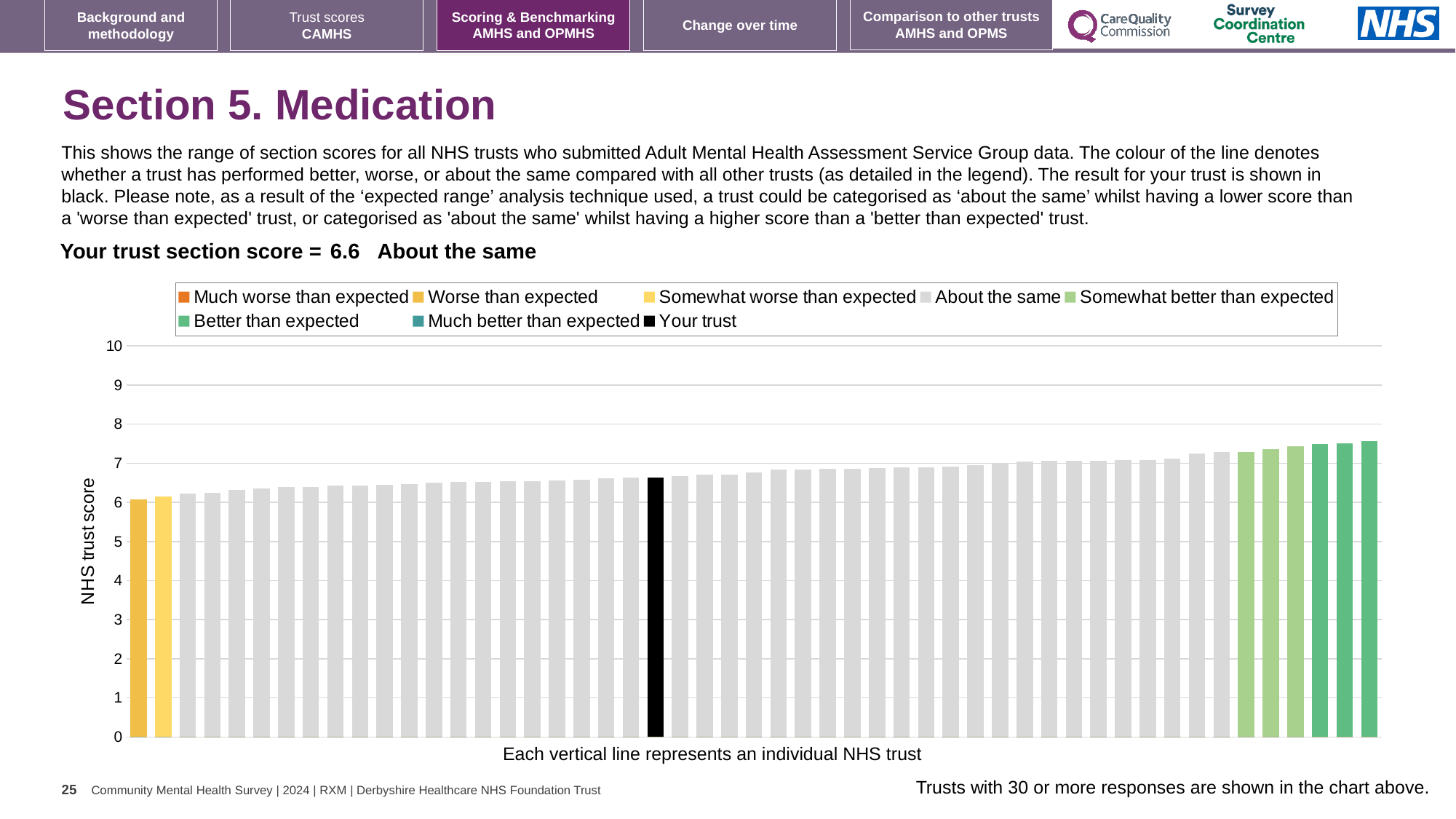
What is the label on the vertical axis of the chart? NHS trust score Is the value of the leftmost bar greater or less than 7? less What is the section score for your trust shown above the chart? 6.6 How many bars are shown in yellow shades (worse or somewhat worse than expected)? 2 What is the maximum value shown on the vertical axis? 10 What kind of chart is shown on the slide? bar chart Is the value of the black bar (your trust) greater or less than 6? greater How many entries does the chart legend list? 8 Is the value of the tallest bar on the right greater or less than 7? greater What colour is the bar representing your trust? black Do the bar values rise or fall from left to right across the chart? rise How is your trust's score categorised compared with other trusts? About the same